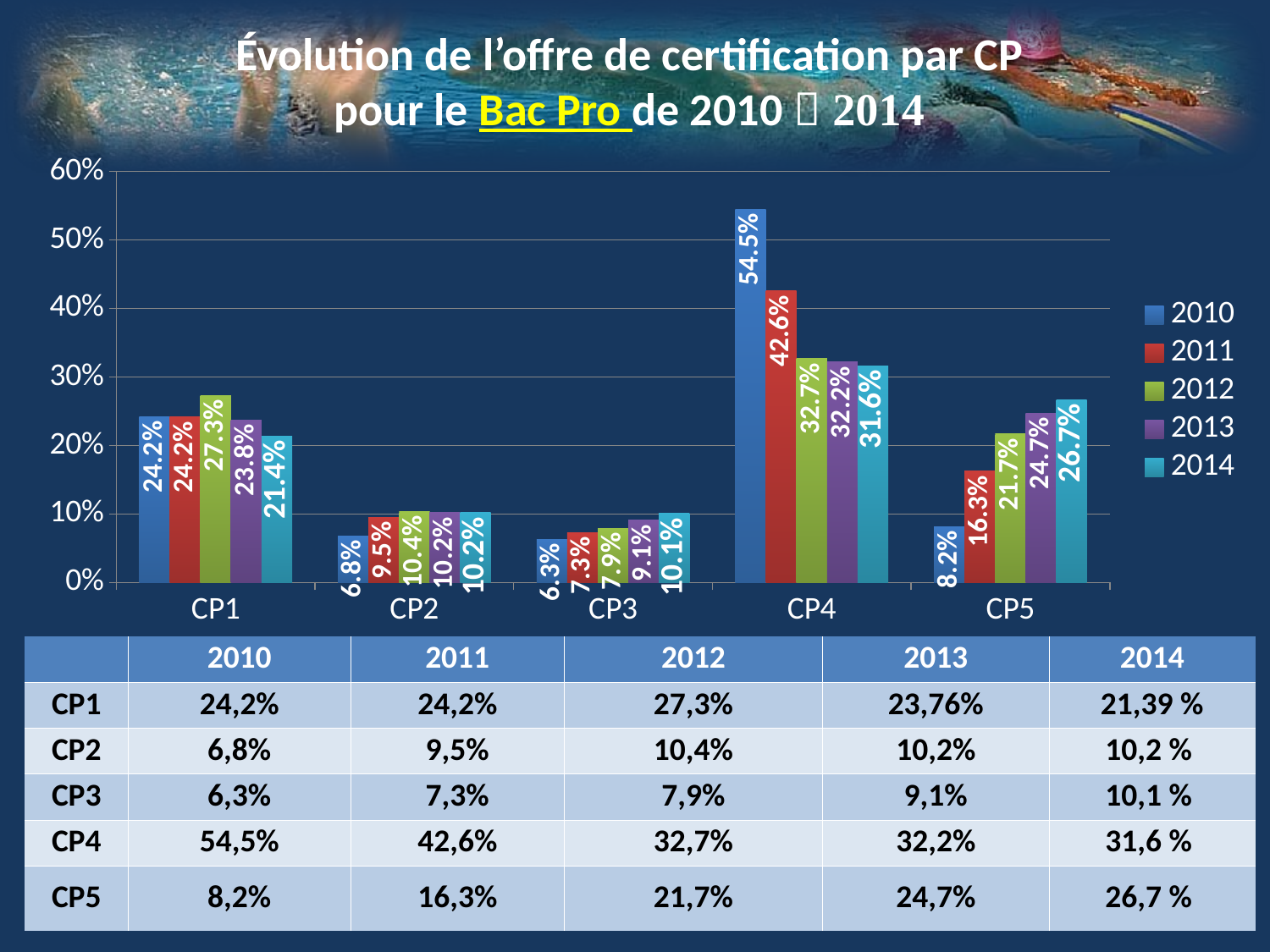
What is the value for CP5 in 2014? 26.7% What kind of chart is shown on the slide? Bar chart How many categories are shown on the x axis? 5 What is the value for CP2 in 2012? 10.4% Do the values for CP5 rise or fall from 2010 to 2014? Rise How many series does the legend list? 5 Which category has the lowest value for the 2010 series? CP3 What is the difference between the 2014 and 2010 values for CP5? 18.5% What is the value for CP4 in 2010? 54.5% Which is larger for CP1: the 2012 value or the 2014 value? 2012 What is the difference between the 2010 and 2011 values for CP4? 11.9% Which category has the highest value for the 2010 series? CP4